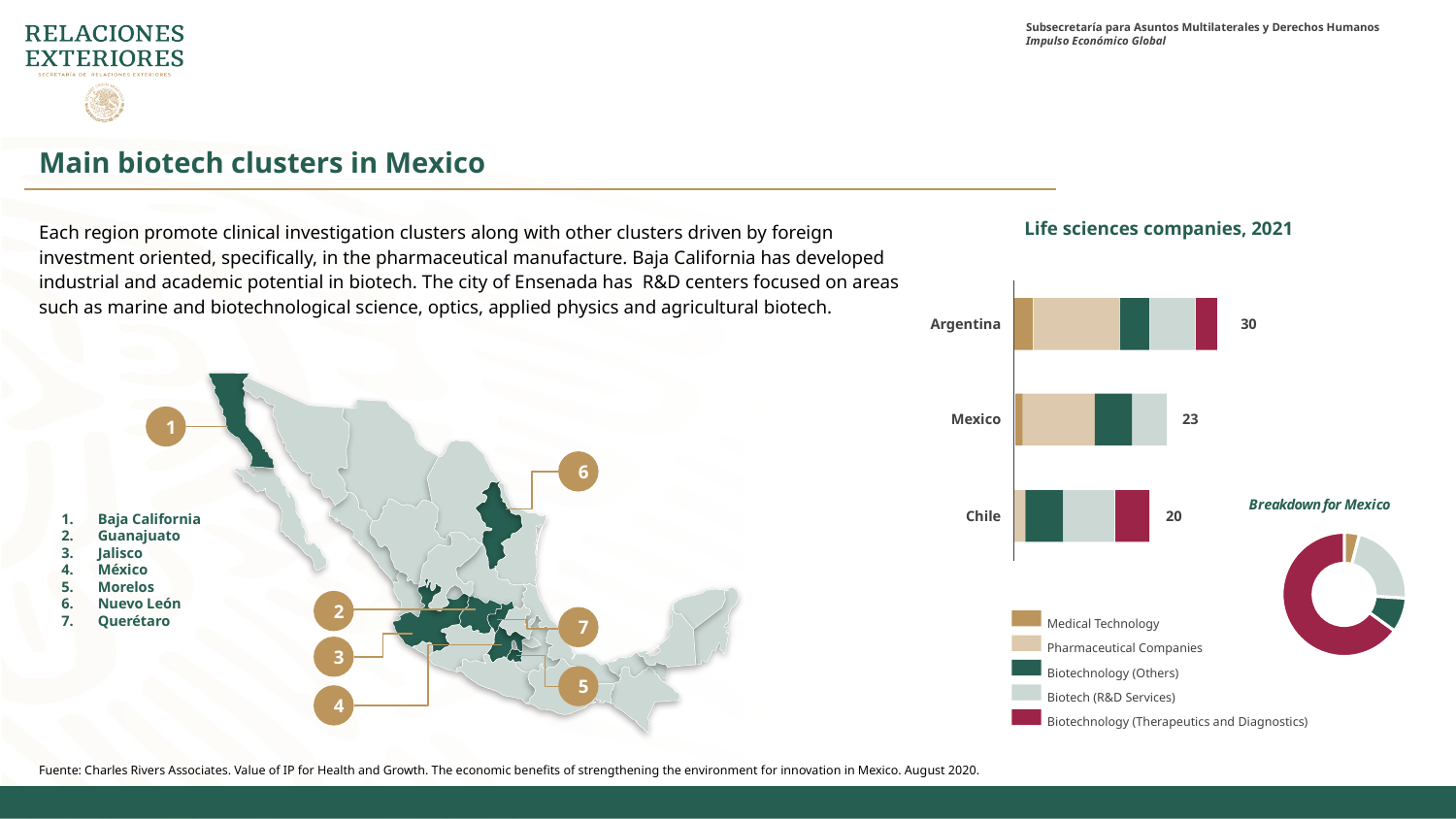
In the 'Life sciences companies, 2021' chart, which country has the lowest total? Chile In the 'Life sciences companies, 2021' chart, what is the difference between the totals for Mexico and Chile? 3 In the 'Life sciences companies, 2021' chart, what is the difference between the totals for Argentina and Mexico? 7 In the 'Life sciences companies, 2021' chart, what is the total number of life sciences companies shown for Mexico? 23 In the 'Life sciences companies, 2021' chart, which has a larger total, Mexico or Chile? Mexico In the 'Life sciences companies, 2021' chart, what is the total number of life sciences companies shown for Argentina? 30 In the 'Life sciences companies, 2021' chart, what is the total number of life sciences companies shown for Chile? 20 In the 'Life sciences companies, 2021' chart, which country has the highest total? Argentina How many countries are shown in the 'Life sciences companies, 2021' chart? 3 What is the title of the small donut chart to the right of the 'Life sciences companies, 2021' chart? Breakdown for Mexico What kind of chart is the 'Life sciences companies, 2021' chart? Stacked bar chart How many series does the legend of the 'Life sciences companies, 2021' chart list? 5